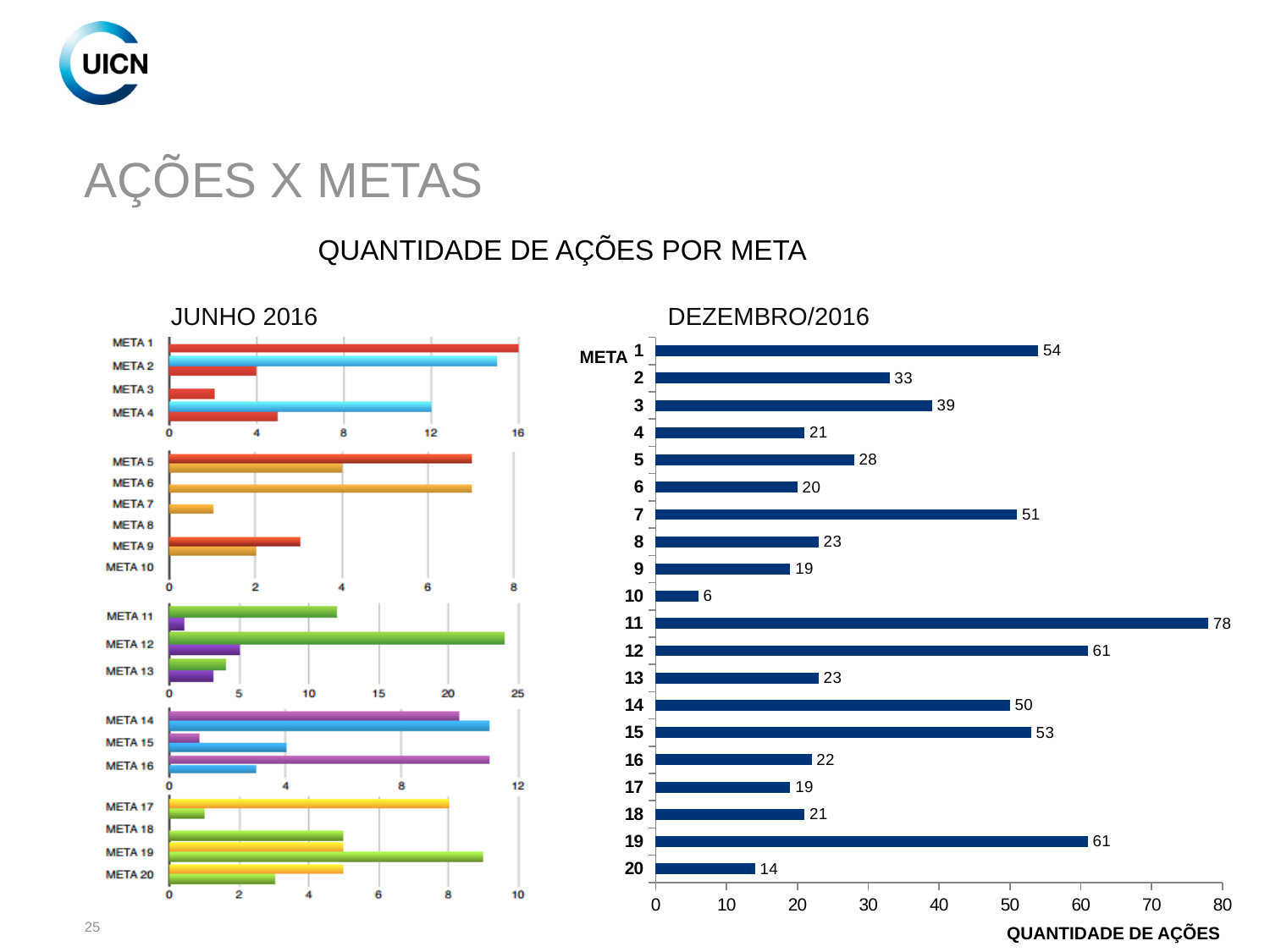
In the DEZEMBRO/2016 chart, what is the difference between the values for META 11 and META 12? 17 How many METAs are shown in the DEZEMBRO/2016 chart? 20 In the DEZEMBRO/2016 chart, what is the difference between the values for META 1 and META 2? 21 In the DEZEMBRO/2016 chart, what is the value for META 20? 14 In the DEZEMBRO/2016 chart, is the value for META 3 greater or less than 30? greater What is the x-axis label of the DEZEMBRO/2016 chart? QUANTIDADE DE AÇÕES In the DEZEMBRO/2016 chart, what is the value for META 11? 78 In the DEZEMBRO/2016 chart, which META has the highest number of actions? META 11 In the DEZEMBRO/2016 chart, which META has the lowest number of actions? META 10 What kind of chart is the DEZEMBRO/2016 chart? Bar chart In the DEZEMBRO/2016 chart, which is larger, the value for META 14 or the value for META 15? META 15 In the DEZEMBRO/2016 chart, what is the value for META 7? 51